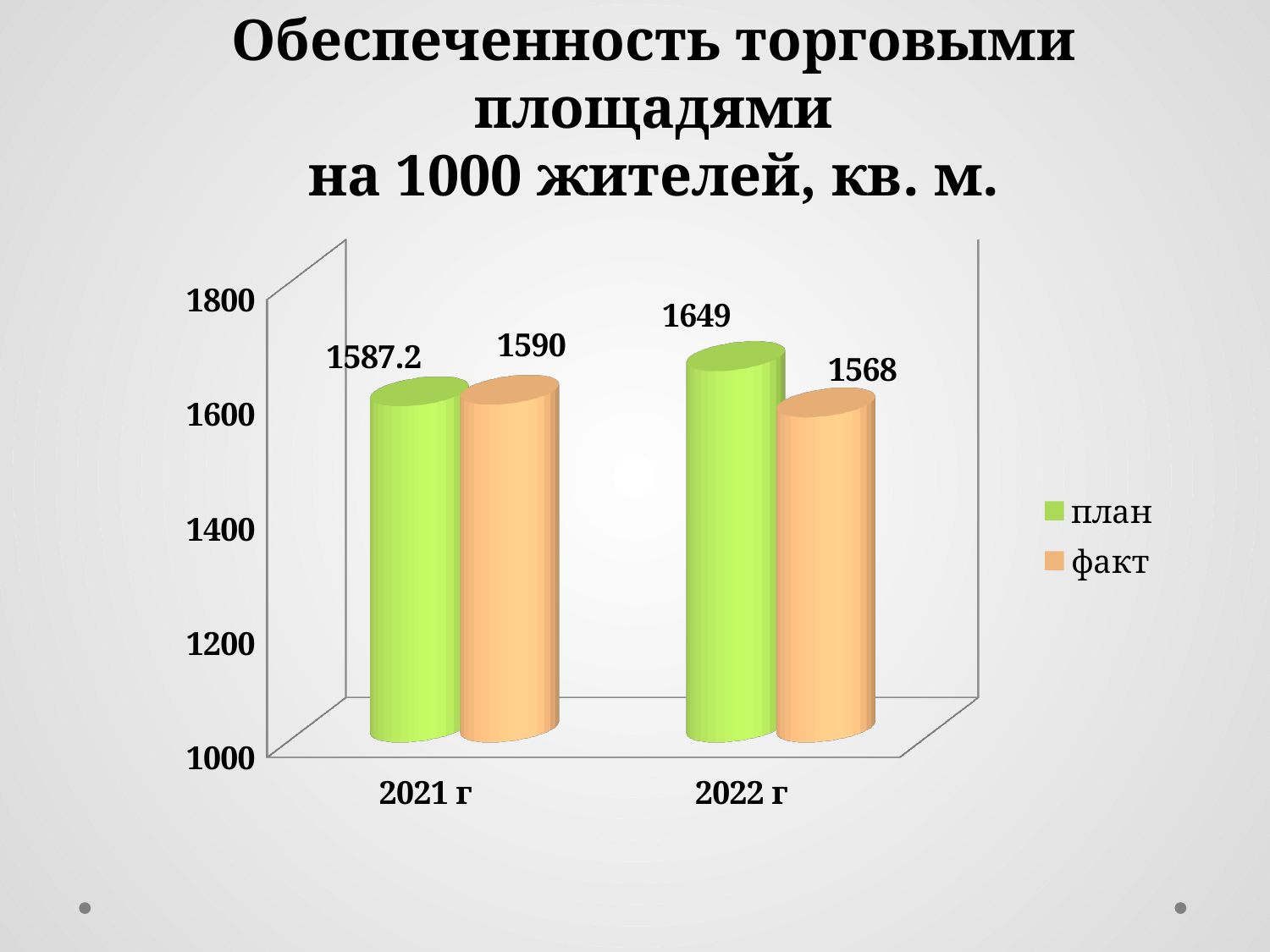
Which is larger for 2022 г, план or факт? план What is the difference between план and факт for 2022 г? 81 What is the value of план for 2022 г? 1649 Is the value of план for 2022 г greater or less than 1600? greater What is the value of факт for 2021 г? 1590 Which year has the lowest факт value? 2022 г What kind of chart is shown on the slide? bar chart What is the value of план for 2021 г? 1587.2 How many series does the legend list? 2 What is the value of факт for 2022 г? 1568 Does the план value rise or fall from 2021 г to 2022 г? rise Which year has the highest план value? 2022 г